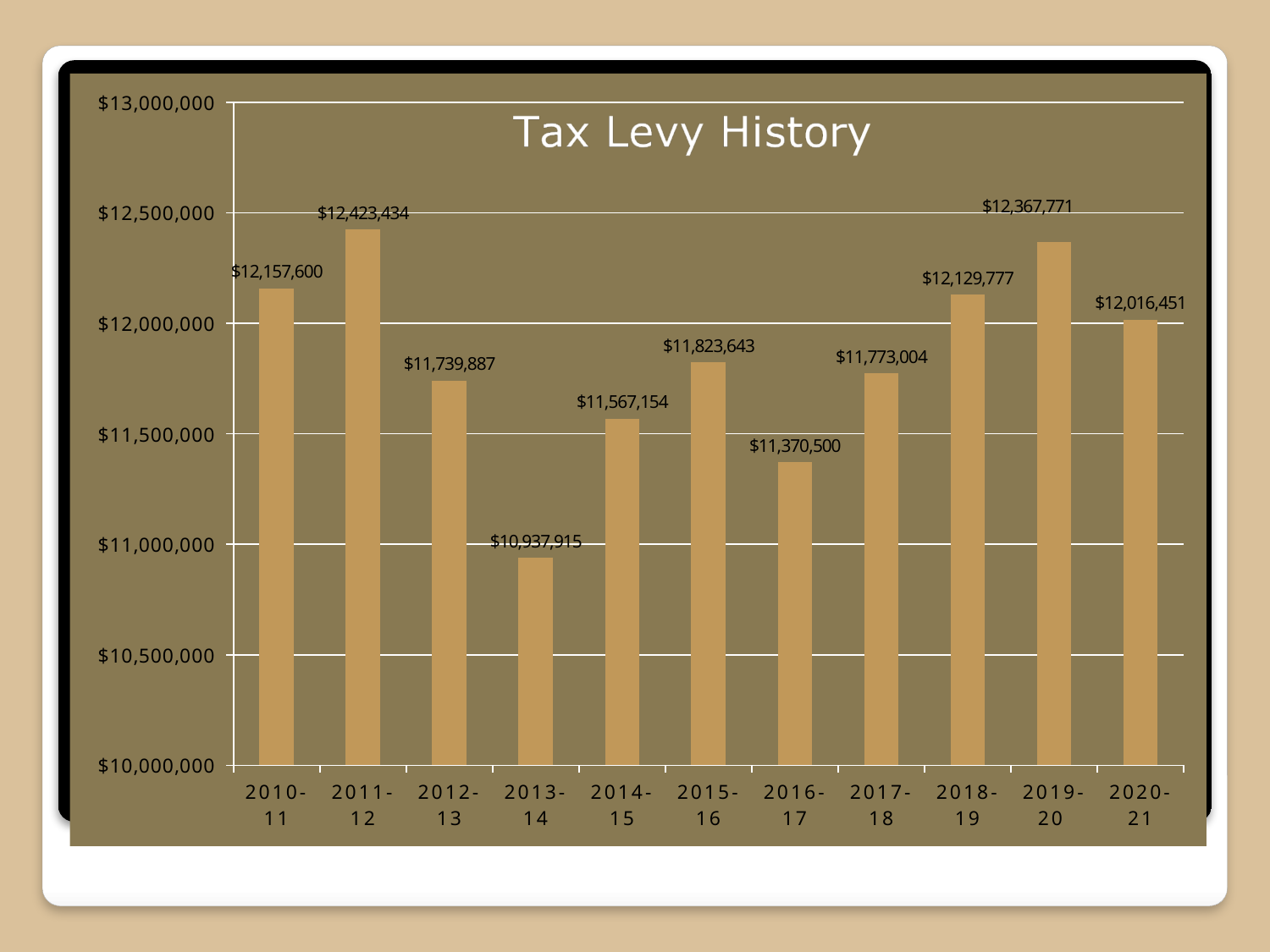
What kind of chart is shown on the slide? bar chart What is the tax levy for 2018-19? $12,129,777 Which year has the highest tax levy? 2011-12 Which year has the larger tax levy, 2015-16 or 2017-18? 2015-16 How many years are shown on the chart? 11 What is the difference between the tax levy in 2011-12 and in 2013-14? $1,485,519 What is the tax levy for 2020-21? $12,016,451 Does the tax levy rise or fall from 2011-12 to 2013-14? fall How much did the tax levy decrease from 2019-20 to 2020-21? $351,320 What is the tax levy for 2013-14? $10,937,915 Is the tax levy for 2016-17 greater or less than $11,500,000? less Which year has the lowest tax levy? 2013-14